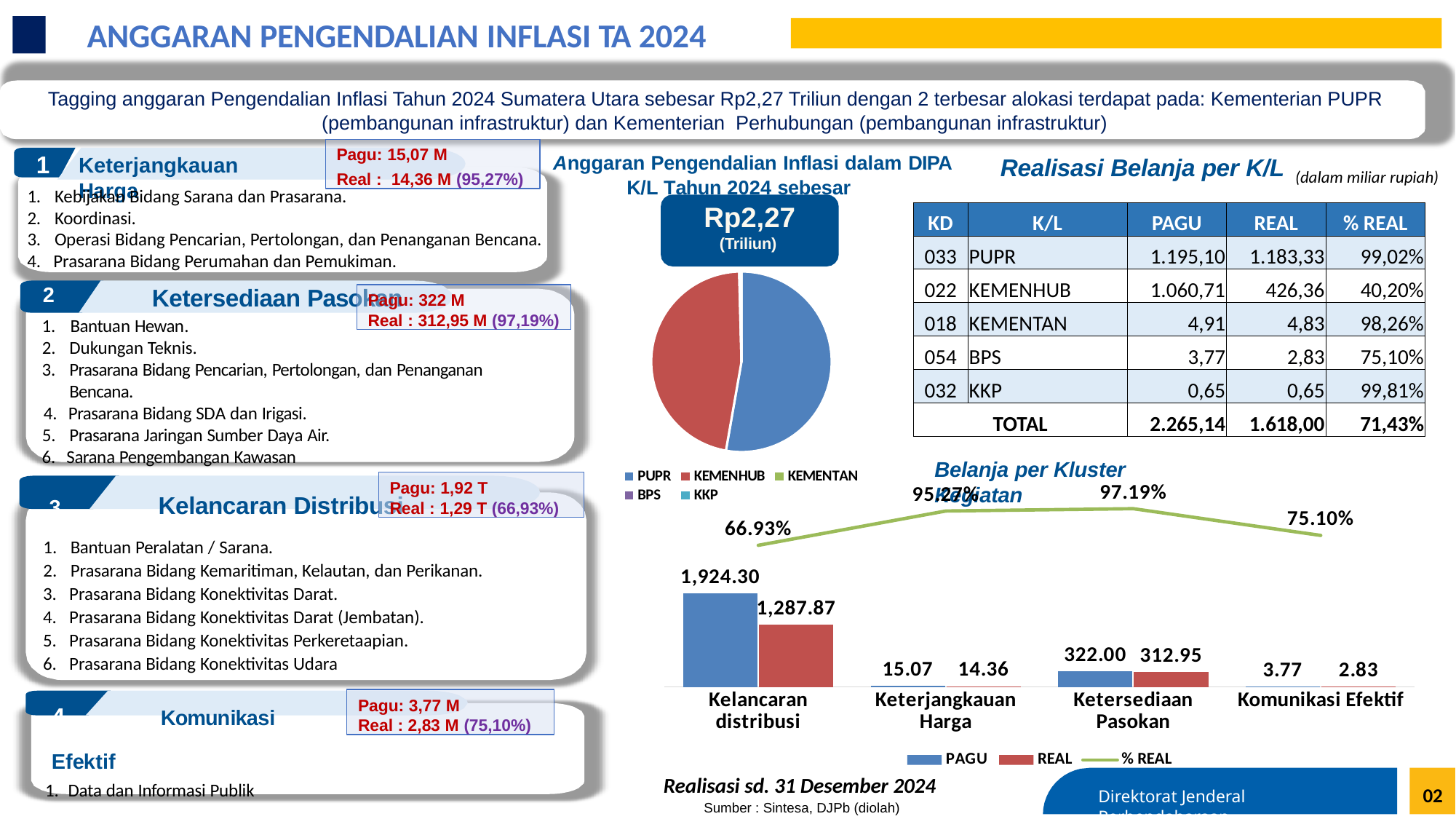
In the Belanja per Kluster Kegiatan chart, which cluster has the lowest REAL value? Komunikasi Efektif In the Belanja per Kluster Kegiatan chart, what is the difference between PAGU and REAL for Ketersediaan Pasokan? 9.05 In the Belanja per Kluster Kegiatan chart, which cluster has the highest PAGU value? Kelancaran distribusi How many clusters are shown on the x axis of the Belanja per Kluster Kegiatan chart? 4 How many entries does the legend of the pie chart under 'Anggaran Pengendalian Inflasi dalam DIPA K/L Tahun 2024' list? 5 In the Belanja per Kluster Kegiatan chart, what is the REAL value for Ketersediaan Pasokan? 312.95 In the Belanja per Kluster Kegiatan chart, what is the % REAL value for Keterjangkauan Harga? 95.27% In the Belanja per Kluster Kegiatan chart, which cluster has the highest % REAL? Ketersediaan Pasokan How many series does the legend of the Belanja per Kluster Kegiatan chart list? 3 In the Belanja per Kluster Kegiatan chart, what is the PAGU value for Kelancaran distribusi? 1,924.30 In the Belanja per Kluster Kegiatan chart, what is the difference between PAGU and REAL for Kelancaran distribusi? 636.43 In the Belanja per Kluster Kegiatan chart, which is larger: the PAGU for Ketersediaan Pasokan or the PAGU for Keterjangkauan Harga? Ketersediaan Pasokan